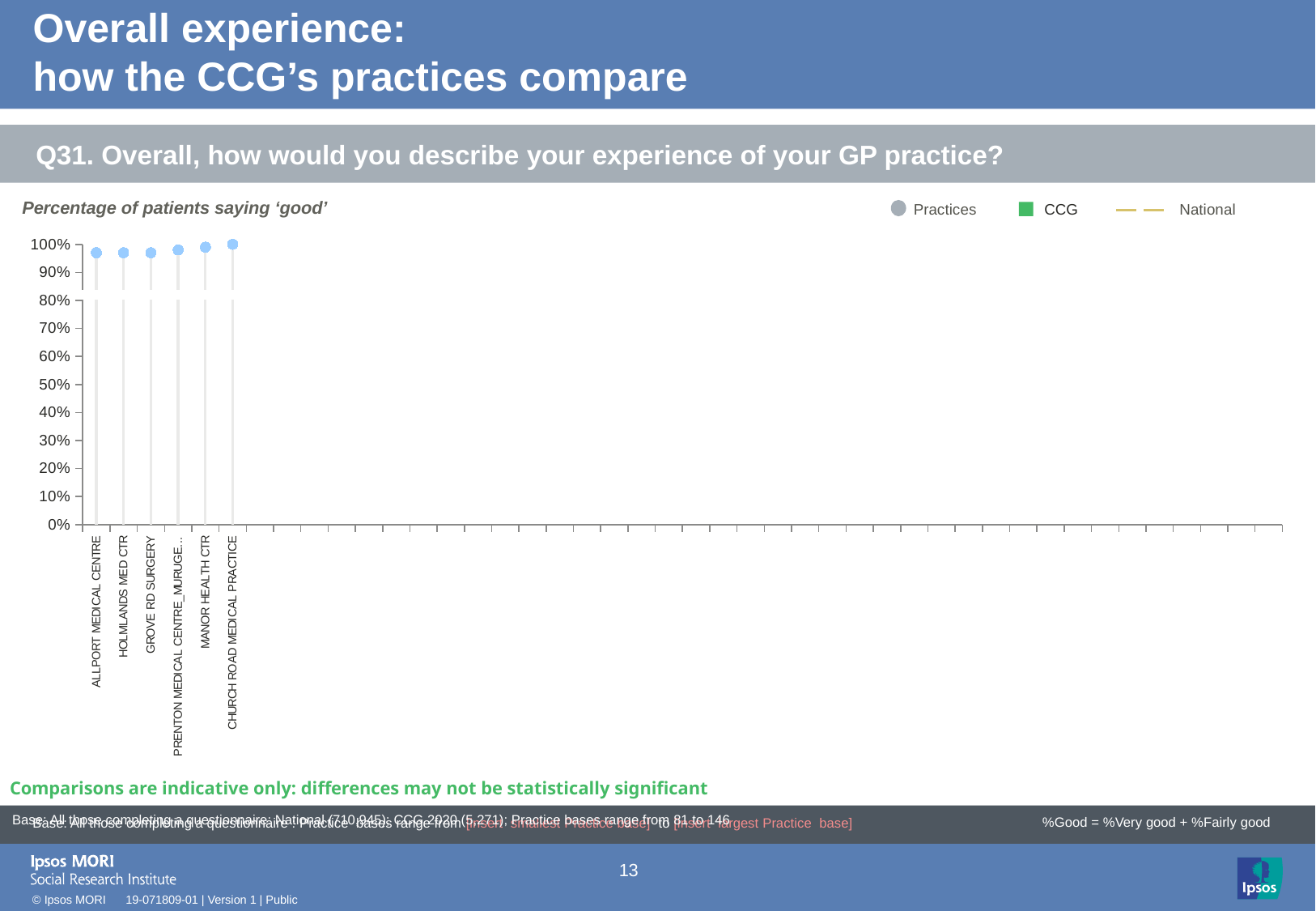
What is the subtitle describing what the chart measures? Percentage of patients saying 'good' Which practice is plotted furthest to the right on the chart? CHURCH ROAD MEDICAL PRACTICE Is the value for ALLPORT MEDICAL CENTRE greater or less than 90%? greater Is the value for HOLMLANDS MED CTR greater or less than 80%? greater What is the highest value shown on the y axis? 100% Is the value for PRENTON MEDICAL CENTRE_MURUGE... greater or less than 90%? greater How many entries does the chart legend list? 3 How many practices are plotted on the chart? 6 Do the plotted values rise or fall moving from left to right along the x axis? rise